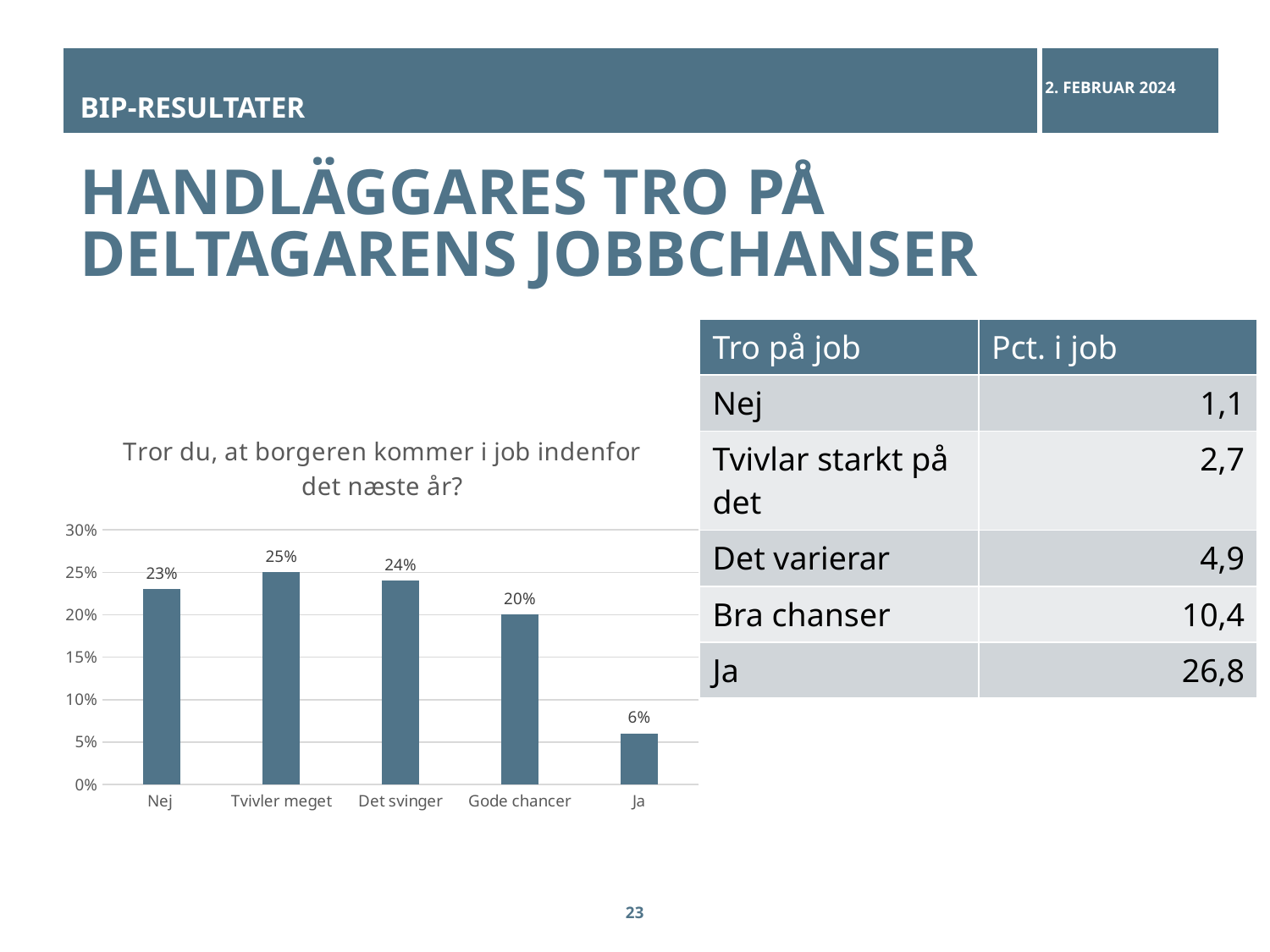
What is the value for "Nej" in the chart? 23% What is the value for "Det svinger" in the chart? 24% Which category has the lowest value in the chart? Ja What is the title of the chart? Tror du, at borgeren kommer i job indenfor det næste år? How many categories are shown in the chart? 5 Which category has the highest value in the chart? Tvivler meget What is the value for "Ja" in the chart? 6% What kind of chart is shown on the slide? bar chart Which is larger, the value for "Nej" or the value for "Gode chancer"? Nej What is the difference between the values for "Gode chancer" and "Ja"? 14% What is the value for "Tvivler meget" in the chart? 25% Is the value for "Ja" greater or less than 10%? less